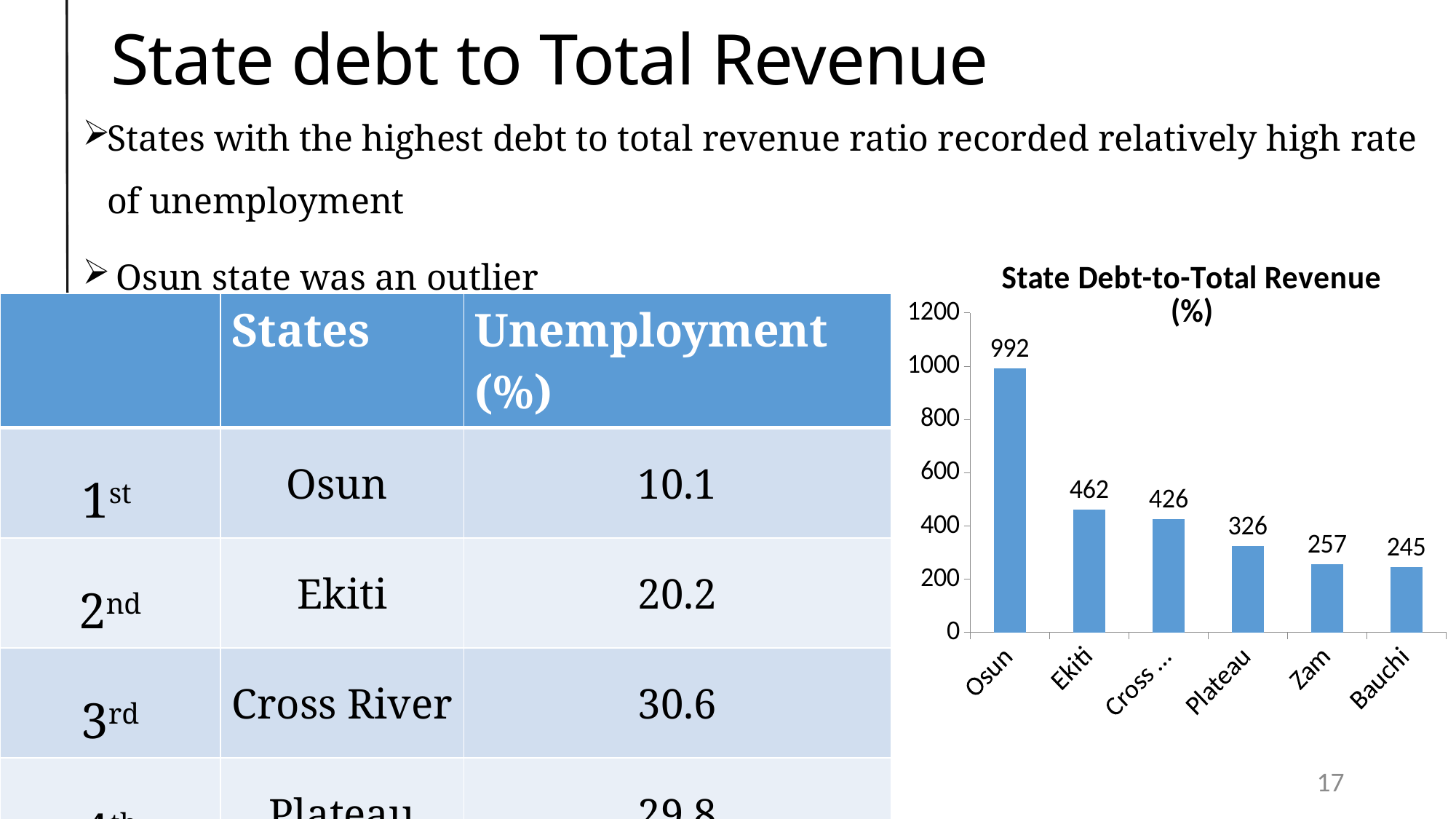
How many states are shown in the State Debt-to-Total Revenue chart? 6 What is the State Debt-to-Total Revenue value for Plateau? 326 What is the State Debt-to-Total Revenue value for Bauchi? 245 What is the difference between the State Debt-to-Total Revenue values for Osun and Ekiti? 530 Which state has the highest State Debt-to-Total Revenue value in the chart? Osun What is the State Debt-to-Total Revenue value for Osun? 992 Which has a larger State Debt-to-Total Revenue value, Plateau or Zam? Plateau What is the State Debt-to-Total Revenue value for Ekiti? 462 Do the values in the State Debt-to-Total Revenue chart rise or fall from left to right? Fall Which state has the lowest State Debt-to-Total Revenue value in the chart? Bauchi What is the difference between the State Debt-to-Total Revenue values for Zam and Bauchi? 12 What kind of chart is the State Debt-to-Total Revenue chart? Bar chart